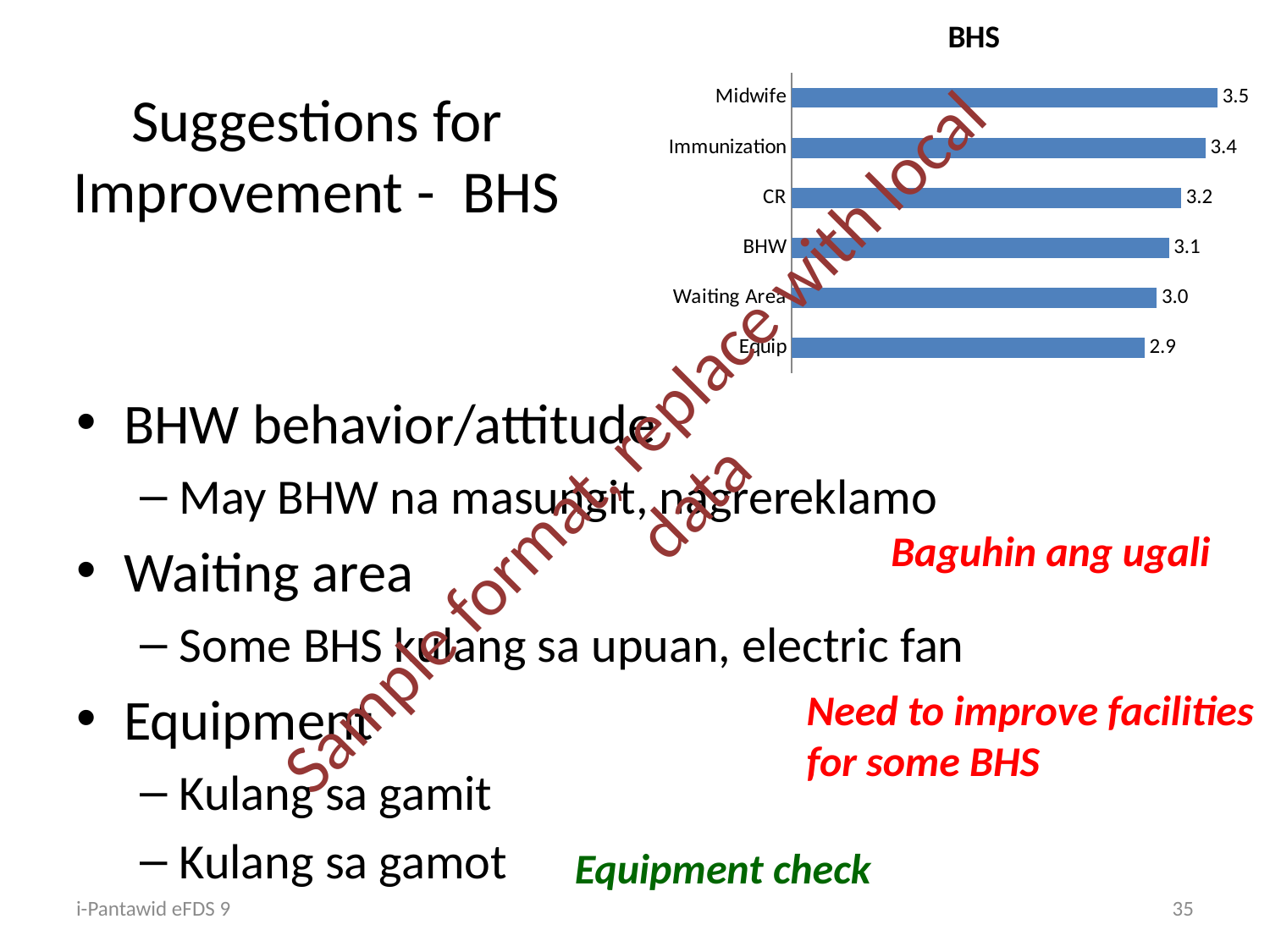
Which has a larger value in the BHS chart, Immunization or Waiting Area? Immunization What is the value for Immunization in the BHS chart? 3.4 What is the value for Waiting Area in the BHS chart? 3.0 Which category has the highest value in the BHS chart? Midwife What is the value for Equip in the BHS chart? 2.9 What is the value for CR in the BHS chart? 3.2 Which category has the lowest value in the BHS chart? Equip What kind of chart is the BHS chart? Bar chart What is the difference between the values for CR and BHW in the BHS chart? 0.1 What is the difference between the values for Midwife and Equip in the BHS chart? 0.6 How many categories are shown in the BHS chart? 6 What is the value for Midwife in the BHS chart? 3.5